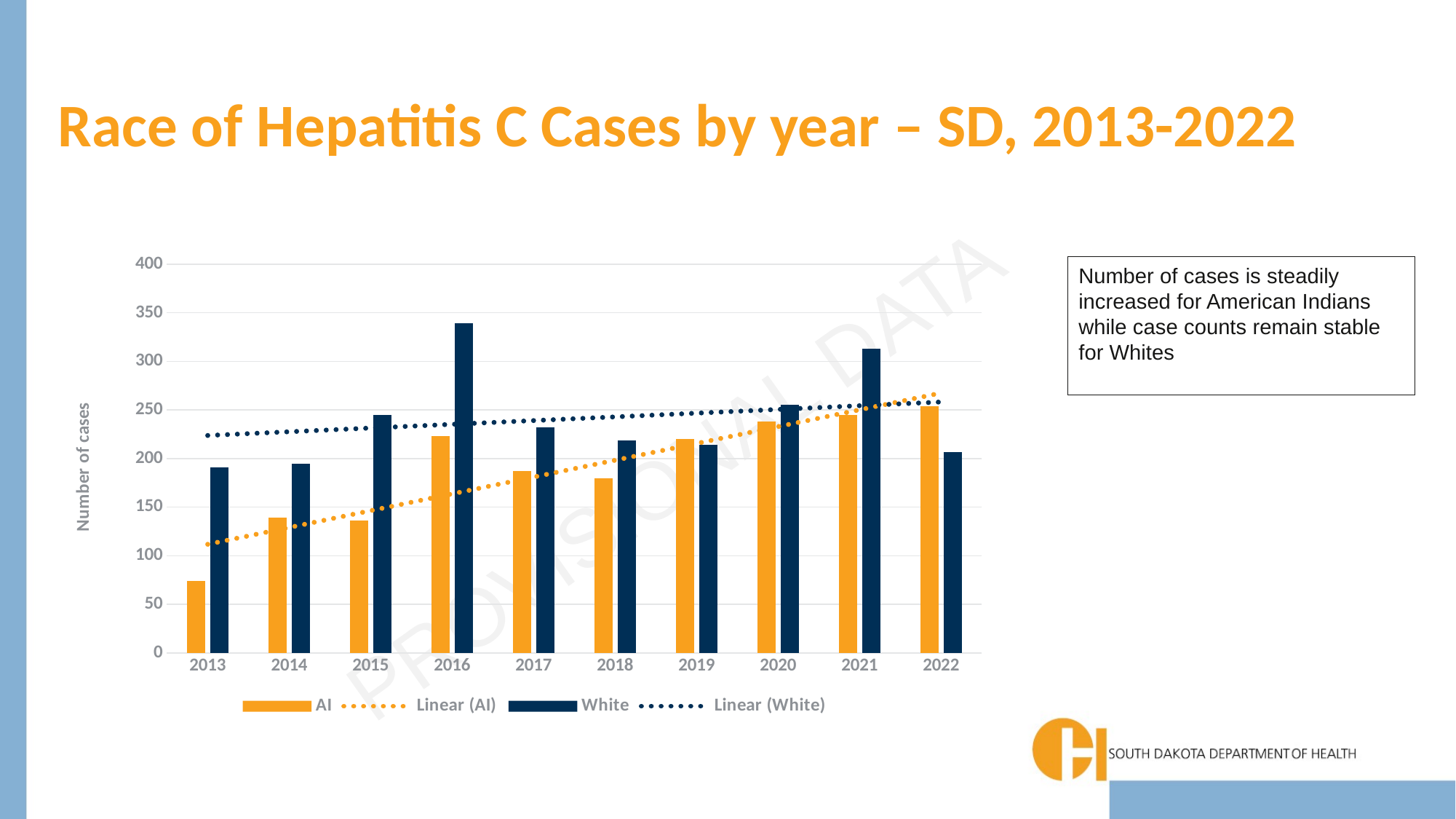
What kind of chart is shown on the slide? Bar chart In 2013, which series has more cases, AI or White? White In which year is the number of AI cases lowest? 2013 How many years are shown on the x axis of the chart? 10 Does the Linear (AI) trend line rise or fall from 2013 to 2022? Rise In 2022, which series has more cases, AI or White? AI Is the value for AI in 2013 greater or less than 100? less How many entries does the chart's legend list? 4 What is the title of the chart's vertical axis? Number of cases Is the value for White in 2016 greater or less than 300? greater In which year is the number of White cases highest? 2016 Is the value for White in 2021 greater or less than 300? greater